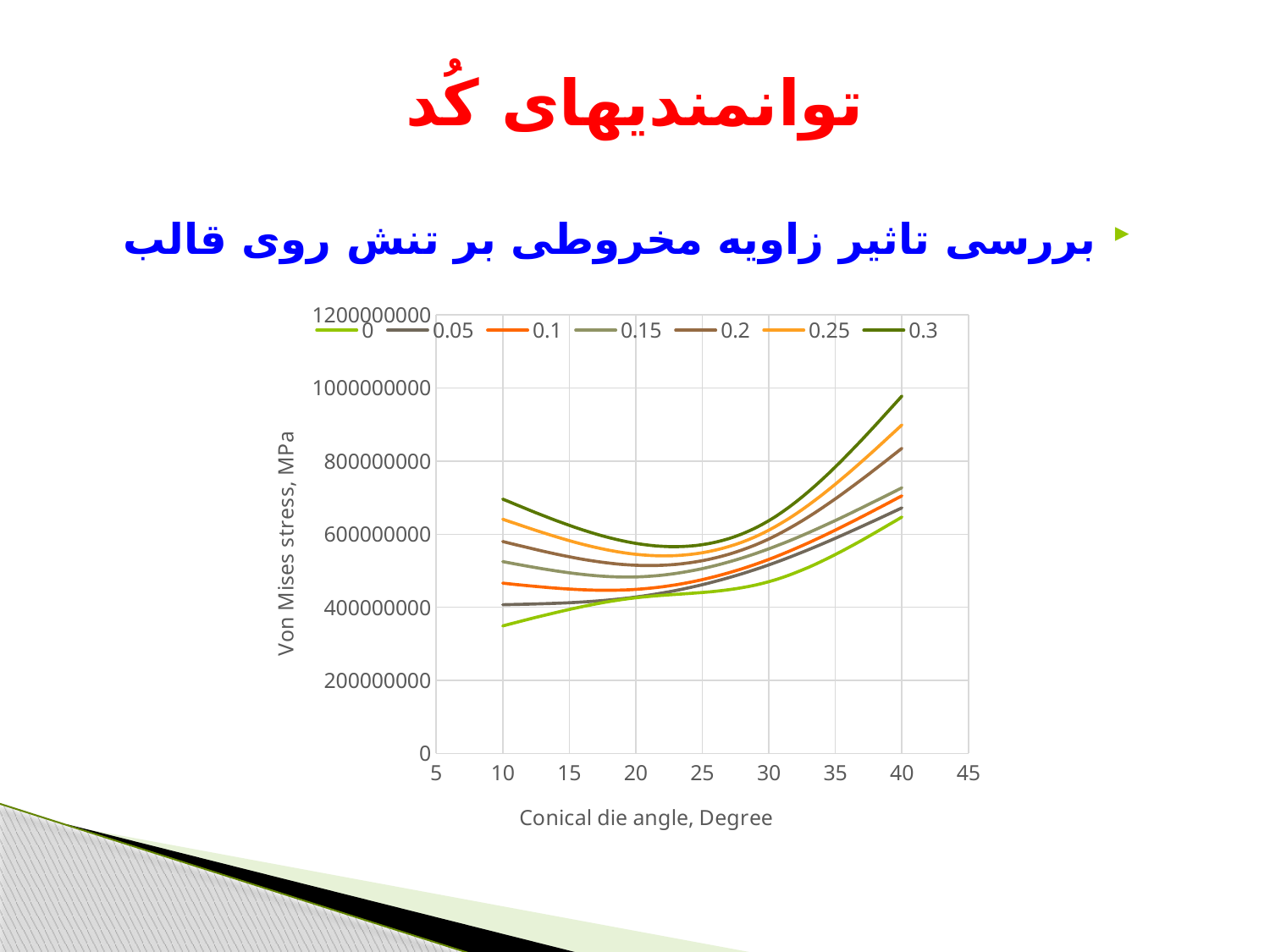
Is the value of the 0.3 series at 10 degrees greater or less than 600000000? greater How many series does the chart legend list? 7 Which series has the lowest Von Mises stress at a conical die angle of 10 degrees? 0 Which series has the highest Von Mises stress at a conical die angle of 40 degrees? 0.3 Is the value of the 0.3 series at 40 degrees greater or less than 800000000? greater At 10 degrees, is the value of the 0.3 series larger or smaller than the value of the 0.1 series? larger Which series has the lowest Von Mises stress at a conical die angle of 40 degrees? 0 What is the title of the vertical axis of the chart? Von Mises stress, MPa What kind of chart is shown on the slide? line chart Does the 0 series rise or fall as the conical die angle increases from 10 to 40 degrees? rise Is the value of the 0 series at 10 degrees greater or less than 400000000? less What is the title of the horizontal axis of the chart? Conical die angle, Degree